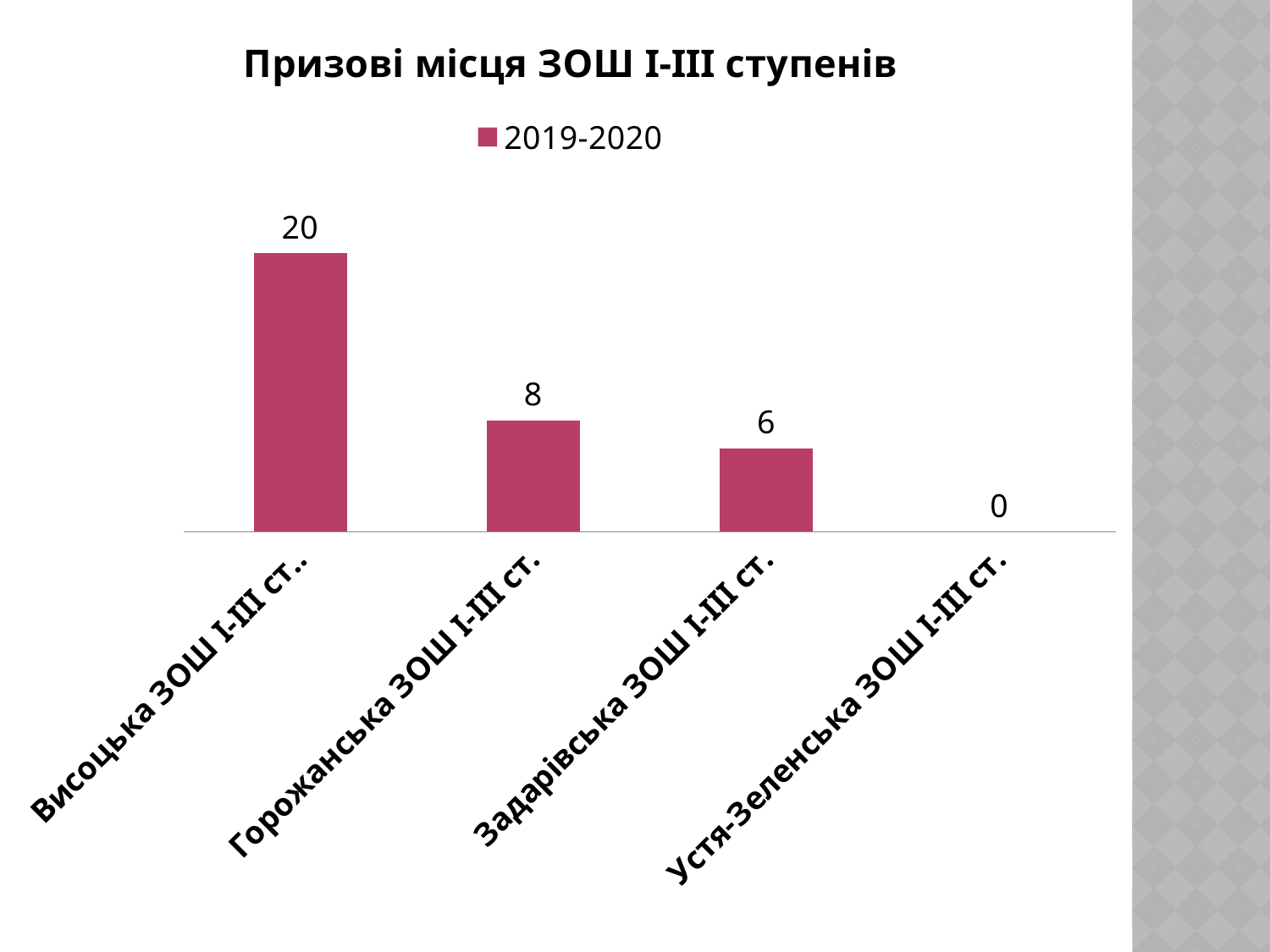
Which school has the lowest number of prize places? Устя-Зеленська ЗОШ I-III ст. What is the value for Устя-Зеленська ЗОШ I-III ст.? 0 How many schools are shown on the chart? 4 What is the value for Висоцька ЗОШ I-III ст.? 20 What is the value for Горожанська ЗОШ I-III ст.? 8 What is the value for Задарівська ЗОШ I-III ст.? 6 Which is larger, the value for Горожанська ЗОШ I-III ст. or Задарівська ЗОШ I-III ст.? Горожанська ЗОШ I-III ст. What is the difference between the values for Горожанська ЗОШ I-III ст. and Задарівська ЗОШ I-III ст.? 2 How many series does the legend list? 1 What is the difference between the values for Висоцька ЗОШ I-III ст. and Горожанська ЗОШ I-III ст.? 12 What kind of chart is this? Bar chart Which school has the highest number of prize places? Висоцька ЗОШ I-III ст.